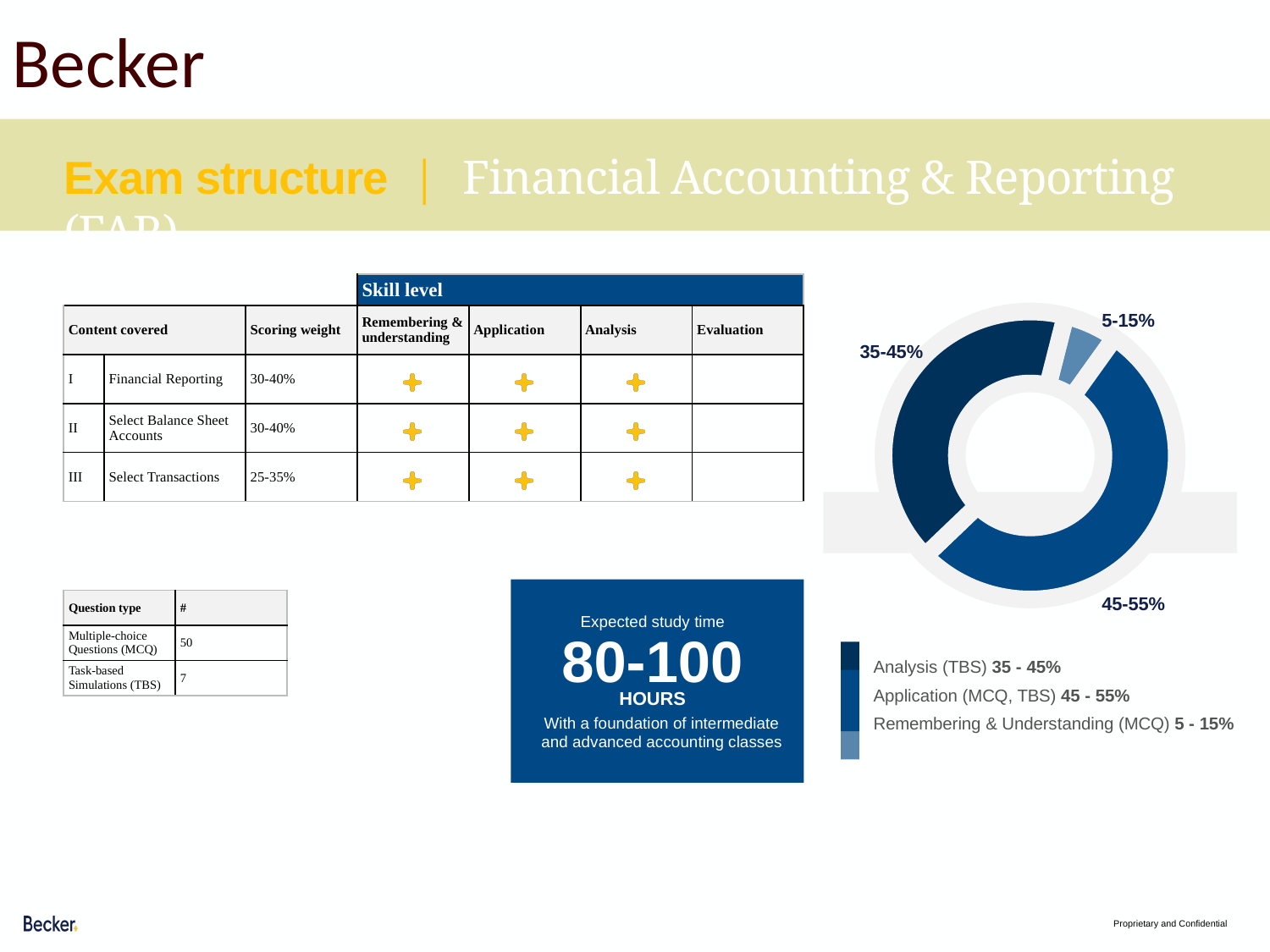
What range is shown for the Application (MCQ, TBS) slice of the donut chart? 45 - 55% In the donut chart, which slice is larger: Application (MCQ, TBS) or Analysis (TBS)? Application (MCQ, TBS) Which legend entry of the donut chart is shown in the darkest blue colour? Analysis (TBS) Which legend entry of the donut chart is shown in the lightest blue colour? Remembering & Understanding (MCQ) What range is shown for the Analysis (TBS) slice of the donut chart? 35 - 45% What range is shown for the Remembering & Understanding (MCQ) slice of the donut chart? 5 - 15% What kind of chart is shown on the right of the slide? Donut chart Which skill level has the smallest slice in the donut chart? Remembering & Understanding (MCQ) In the donut chart, which slice is larger: Analysis (TBS) or Remembering & Understanding (MCQ)? Analysis (TBS) How many slices does the donut chart have? 3 How many entries does the legend below the donut chart list? 3 Which skill level has the largest slice in the donut chart? Application (MCQ, TBS)